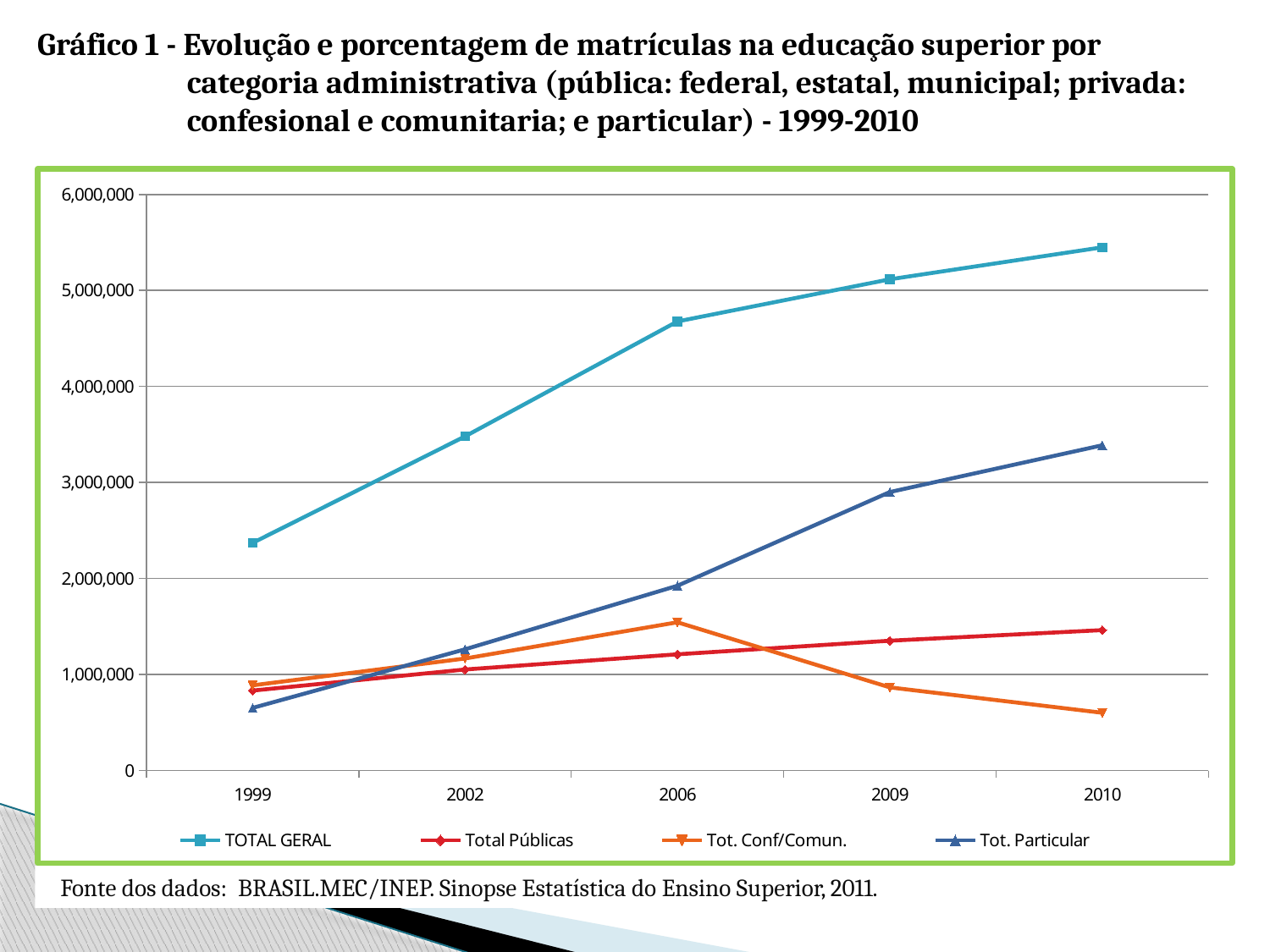
Is the value for Tot. Conf/Comun. in 2010 greater or less than 1,000,000? less Which series has the lowest value in 2010? Tot. Conf/Comun. Which series is drawn in orange? Tot. Conf/Comun. Which series has the highest value in 2010? TOTAL GERAL Does the Tot. Conf/Comun. series rise or fall from 2006 to 2010? fall Does the TOTAL GERAL series rise or fall from 1999 to 2010? rise How many years are shown on the x axis? 5 What kind of chart is shown on the slide? line chart In 2010, which is larger: Tot. Particular or Total Públicas? Tot. Particular How many series does the legend list? 4 Is the value for TOTAL GERAL in 2010 greater or less than 5,000,000? greater